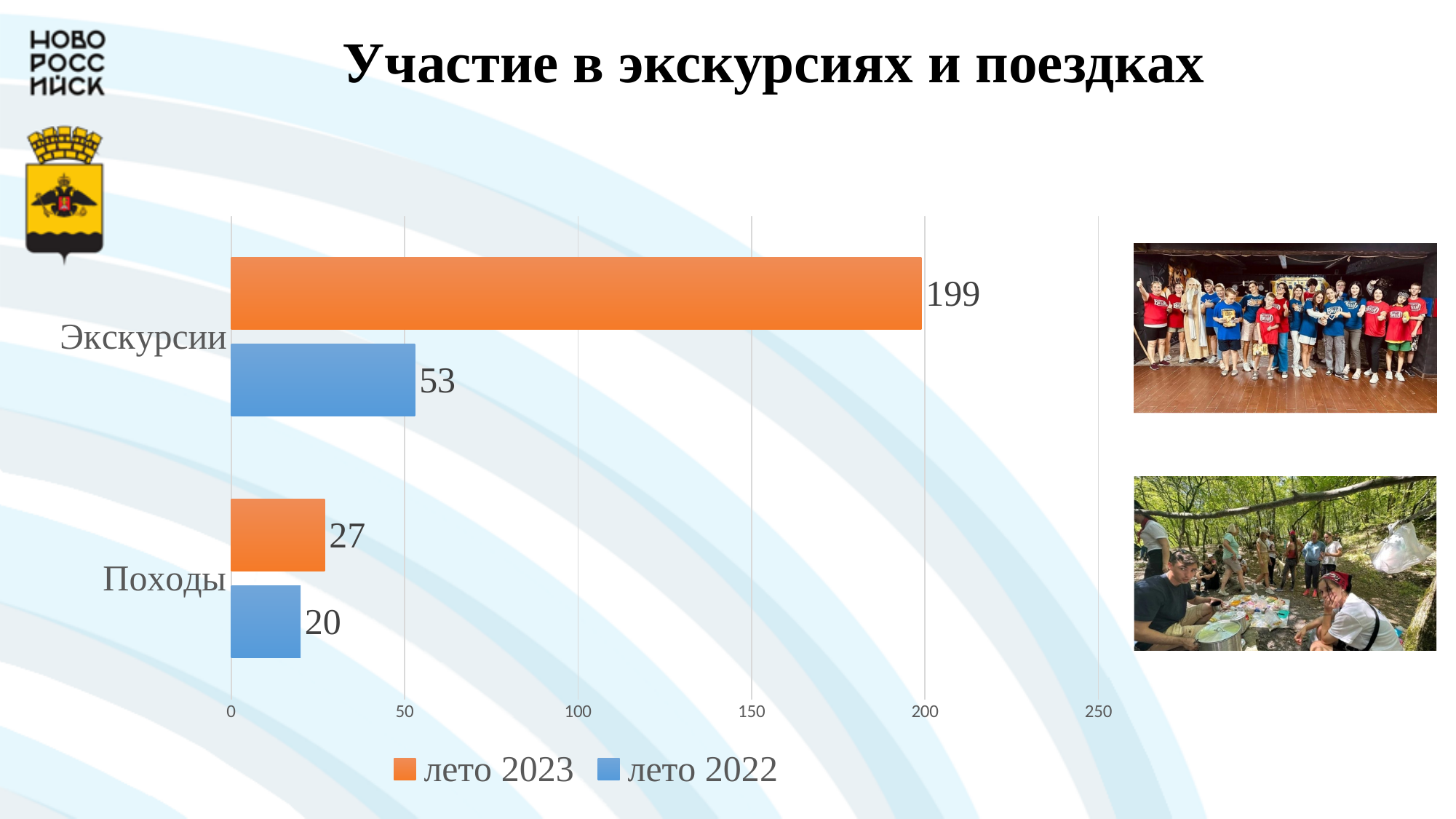
How many categories are shown on the chart? 2 Which category has the highest value in лето 2023? Экскурсии Which is larger for Походы: лето 2023 or лето 2022? лето 2023 What is the value for Экскурсии in лето 2023? 199 What is the difference between the лето 2023 and лето 2022 values for Экскурсии? 146 What is the difference between the лето 2023 and лето 2022 values for Походы? 7 Which category has the lowest value in лето 2022? Походы How many series does the legend list? 2 What is the value for Экскурсии in лето 2022? 53 What kind of chart is shown on the slide? bar chart What is the value for Походы in лето 2022? 20 What is the value for Походы in лето 2023? 27